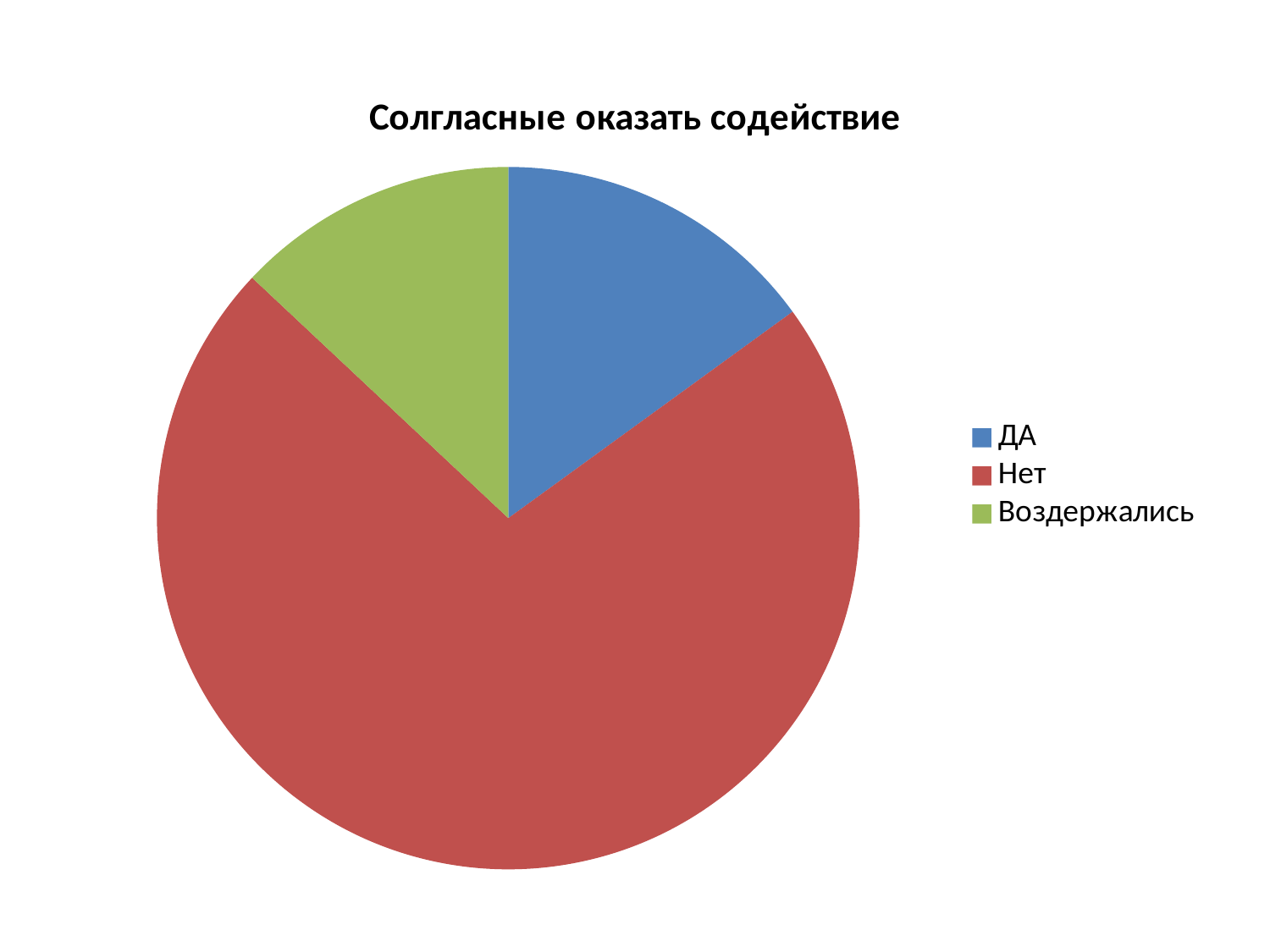
Which slice is larger, Нет or ДА? Нет What kind of chart is shown on the slide? Pie chart How many slices does the pie chart have? 3 How many entries does the legend list? 3 Is the Нет slice greater or less than half of the pie? greater Which slice is larger, Нет or Воздержались? Нет What is the title of the chart? Солгласные оказать содействие Which category has the largest slice of the pie? Нет What colour is the slice for Воздержались? Green